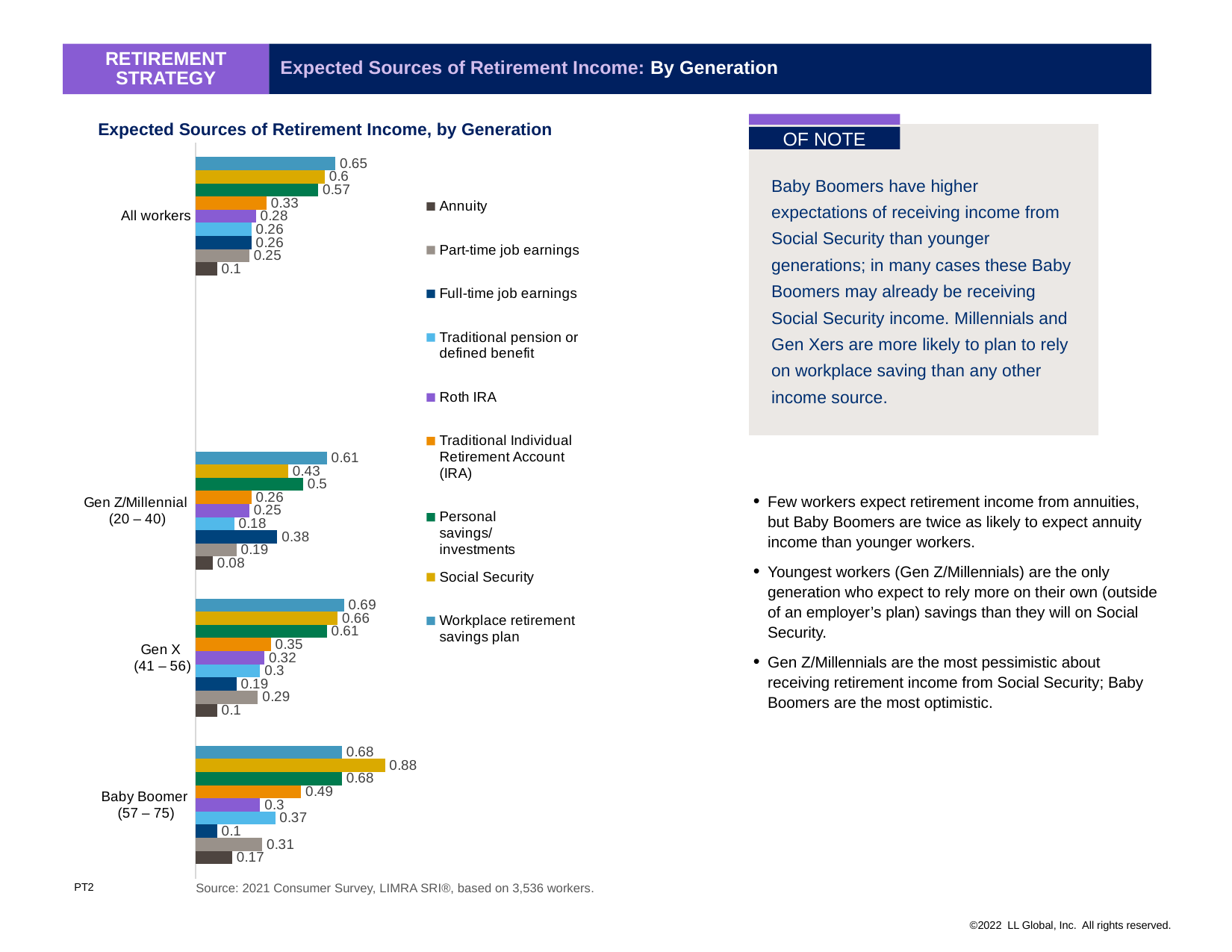
What is the value for Full-time job earnings for Gen Z/Millennial (20 – 40)? 0.38 How many generation groups are shown on the chart? 4 Which generation group has the highest value for Social Security? Baby Boomer (57 – 75) What is the value for Annuity for Gen Z/Millennial (20 – 40)? 0.08 How many series does the legend list? 9 What is the difference between the Social Security value for Baby Boomer (57 – 75) and for Gen Z/Millennial (20 – 40)? 0.45 What is the title of the chart? Expected Sources of Retirement Income, by Generation What is the value for Workplace retirement savings plan for Gen X (41 – 56)? 0.69 What is the value for Social Security for Baby Boomer (57 – 75)? 0.88 Which generation group has the lowest value for Annuity? Gen Z/Millennial (20 – 40) For Gen Z/Millennial (20 – 40), which is larger: Personal savings/investments or Social Security? Personal savings/investments What kind of chart is shown on the slide? Bar chart